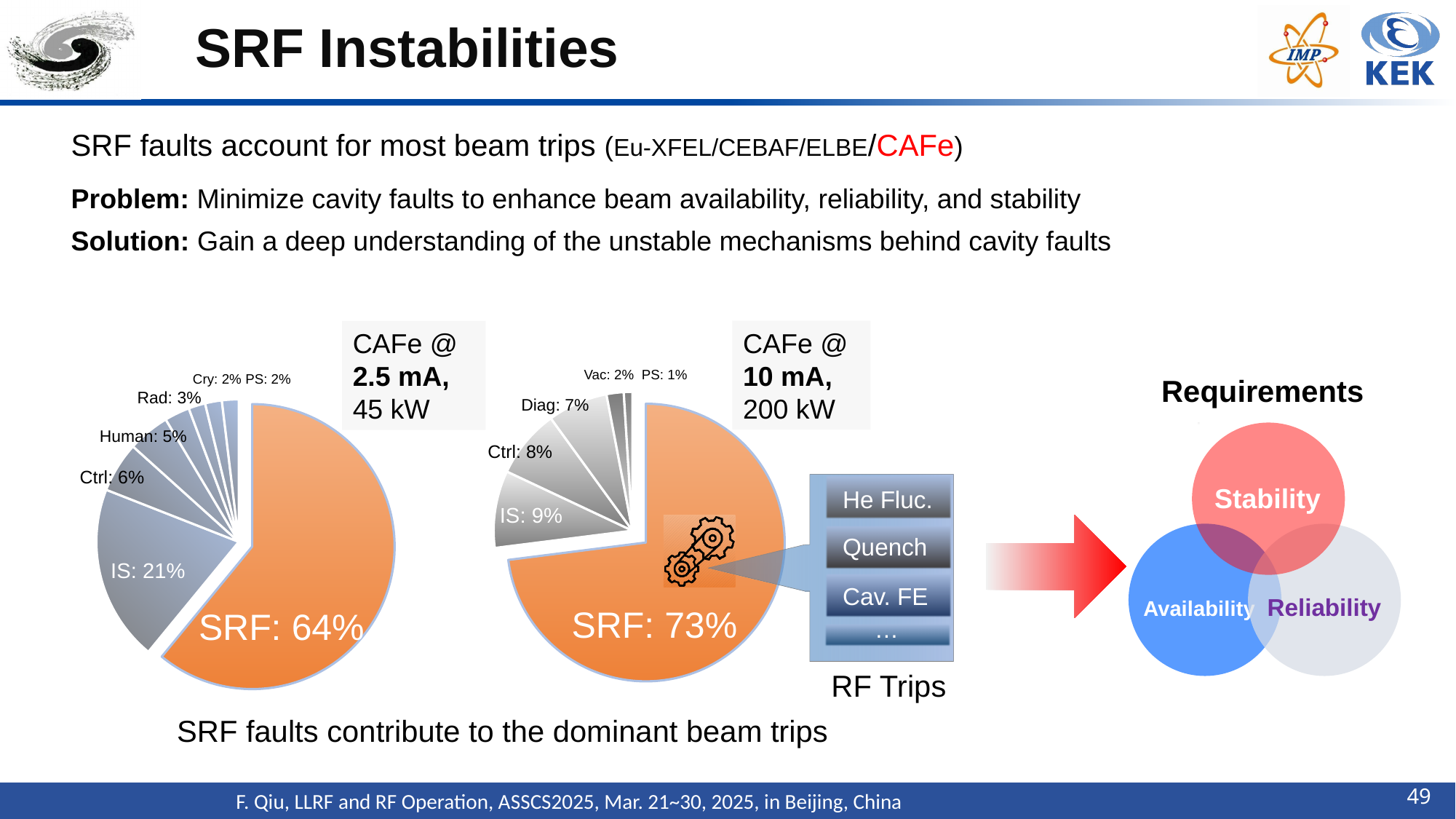
In the right pie chart (CAFe @ 10 mA, 200 kW), what is the value for Diag? 7% In the right pie chart (CAFe @ 10 mA, 200 kW), which is larger, IS or Ctrl? IS In the left pie chart (CAFe @ 2.5 mA, 45 kW), what is the value for Human? 5% How many slices does the right pie chart (CAFe @ 10 mA, 200 kW) have? 6 In the right pie chart (CAFe @ 10 mA, 200 kW), what share of beam trips is attributed to SRF? 73% In the right pie chart (CAFe @ 10 mA, 200 kW), which category has the smallest share? PS What type of chart is used to show the beam trip breakdown for CAFe @ 2.5 mA? Pie chart In the left pie chart (CAFe @ 2.5 mA, 45 kW), what is the value for IS? 21% In the left pie chart (CAFe @ 2.5 mA, 45 kW), which category has the largest share? SRF How many slices does the left pie chart (CAFe @ 2.5 mA, 45 kW) have? 8 What is the difference between the SRF share in the right pie chart (10 mA) and the SRF share in the left pie chart (2.5 mA)? 9% In the left pie chart (CAFe @ 2.5 mA, 45 kW), what share of beam trips is attributed to SRF? 64%